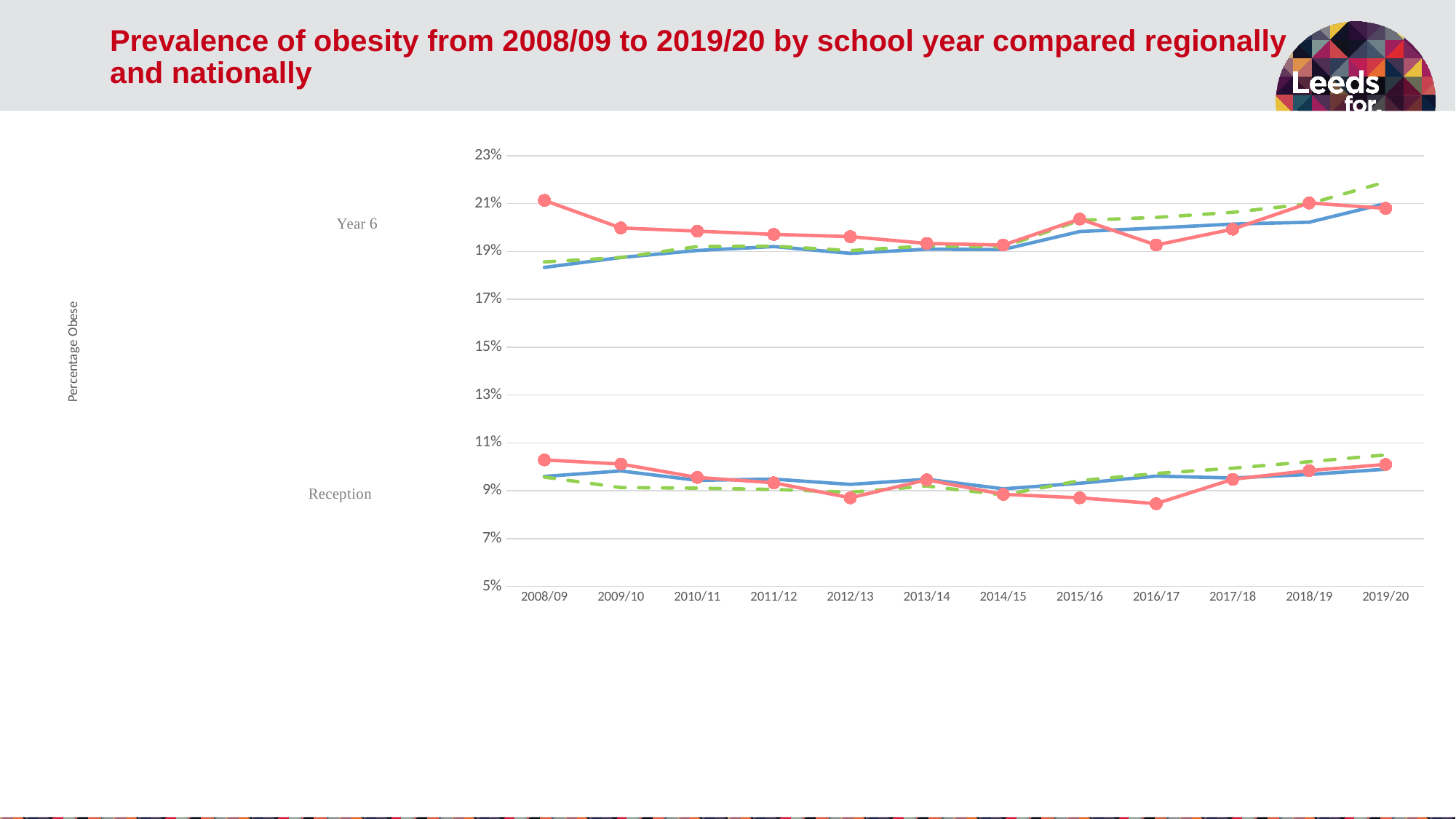
Does the Year 6 red line with markers rise or fall from 2008/09 to 2014/15? fall What is the label on the vertical axis? Percentage Obese Are all the Reception values greater or less than 13%? less Are all the Year 6 values greater or less than 17%? greater For the Year 6 red line with markers, is the value in 2008/09 or in 2016/17 larger? 2008/09 What kind of chart is shown on the slide? line chart What is the first school year shown on the x axis? 2008/09 Is the Reception value for the red line with markers in 2008/09 greater or less than 9%? greater How many school years are shown along the x axis? 12